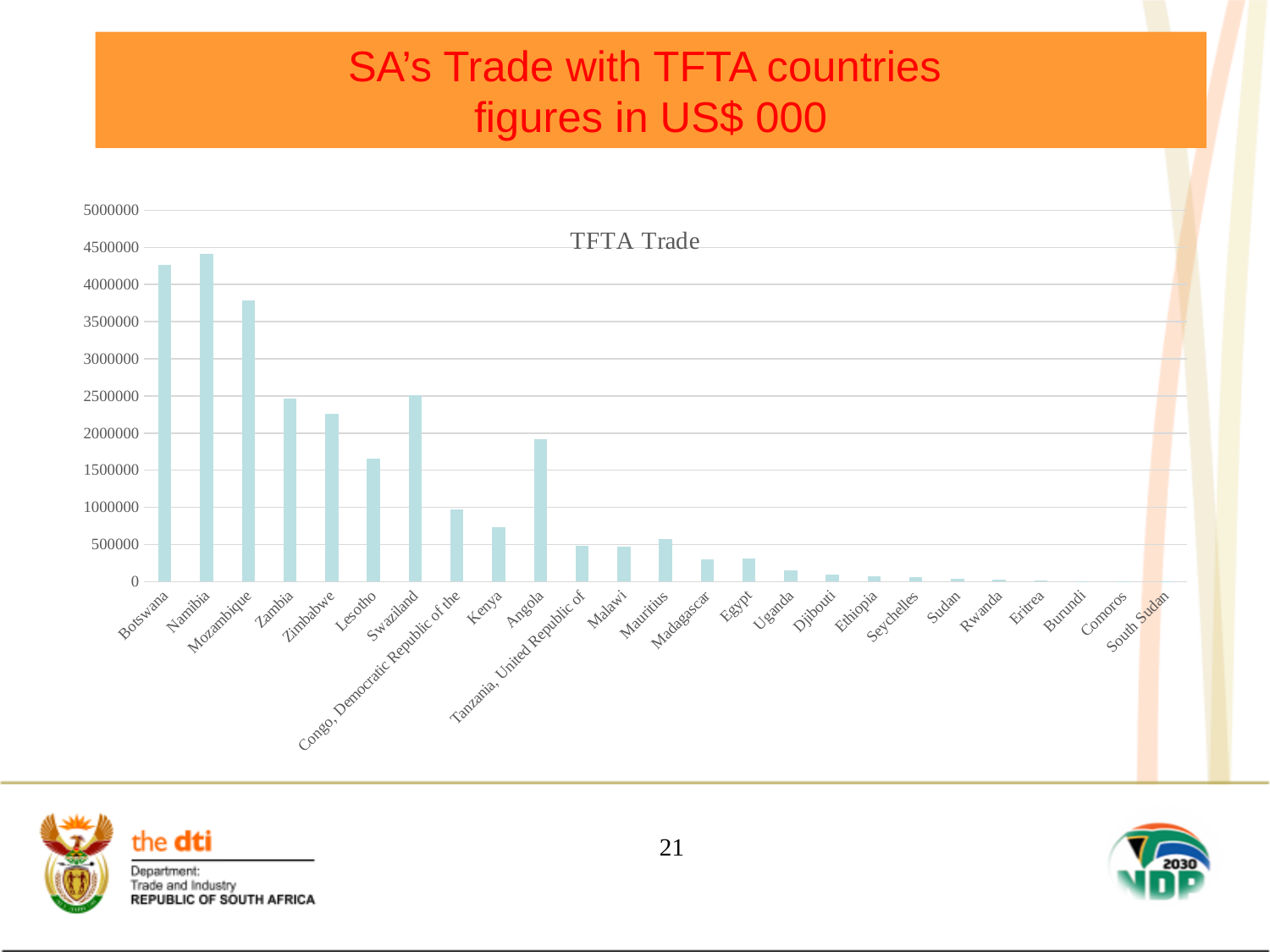
Is the value for Mozambique greater or less than 4000000? less Which has the larger value, Angola or Lesotho? Angola Is the value for Kenya greater or less than 1000000? less Is the value for Botswana greater or less than 4000000? greater What is the title shown inside the chart area? TFTA Trade Which has the larger value, Mozambique or Zambia? Mozambique Which country has the highest trade value in the chart? Namibia What kind of chart is shown on the slide? bar chart Which has the larger value, Swaziland or Zimbabwe? Swaziland How many countries are plotted on the x axis of the chart? 25